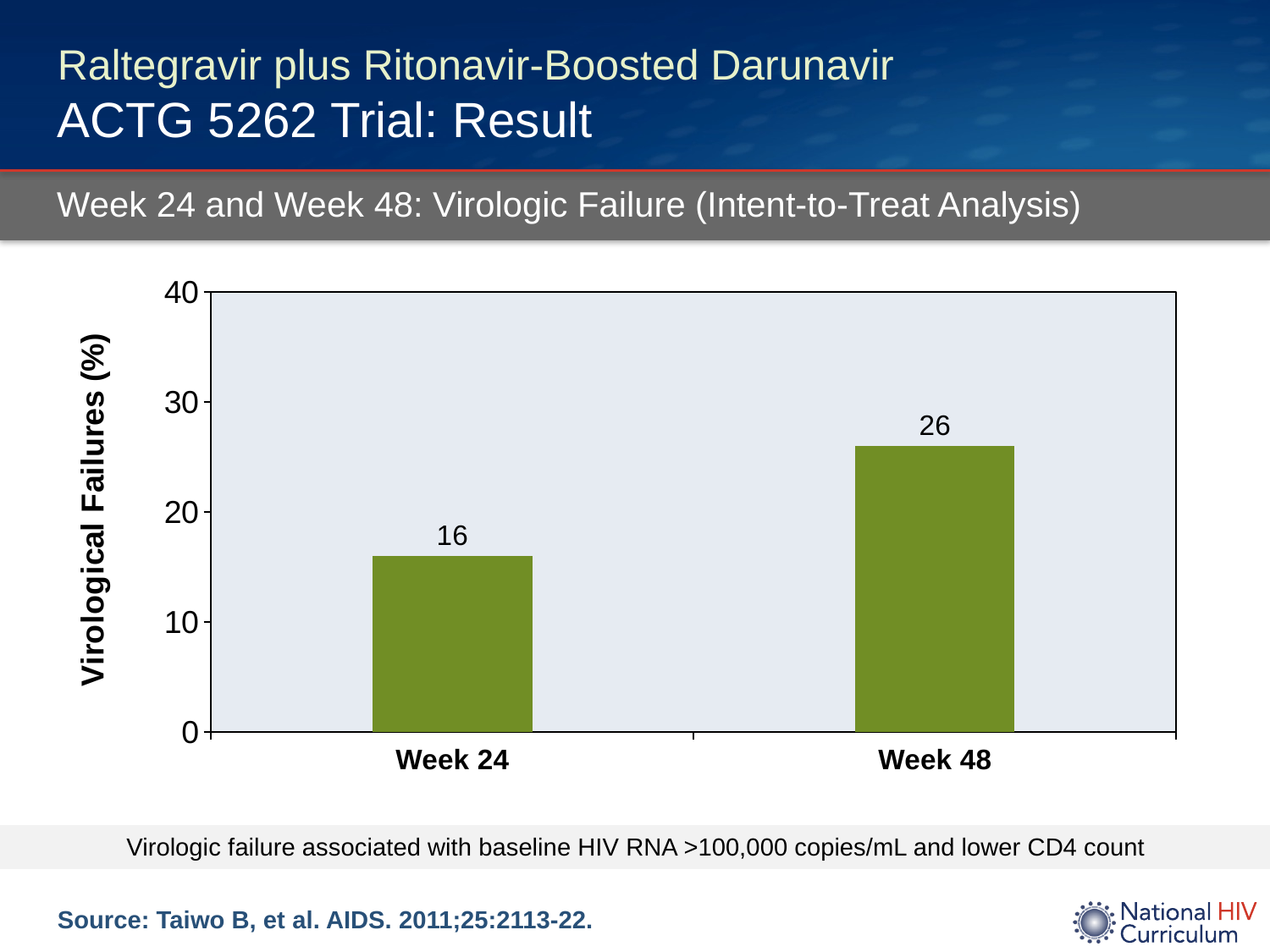
What is the virological failure percentage at Week 24? 16 What is the label of the y axis? Virological Failures (%) Which time point has the higher virological failure percentage? Week 48 What is the difference in virological failures between Week 48 and Week 24? 10 What kind of chart is shown on the slide? Bar chart Which time point has the lower virological failure percentage? Week 24 Is the value for Week 48 greater or less than 30? less Is the value for Week 24 greater or less than 20? less Do the values rise or fall from Week 24 to Week 48? Rise What is the virological failure percentage at Week 48? 26 How many categories are shown on the x axis? 2 What is the maximum value shown on the y axis? 40